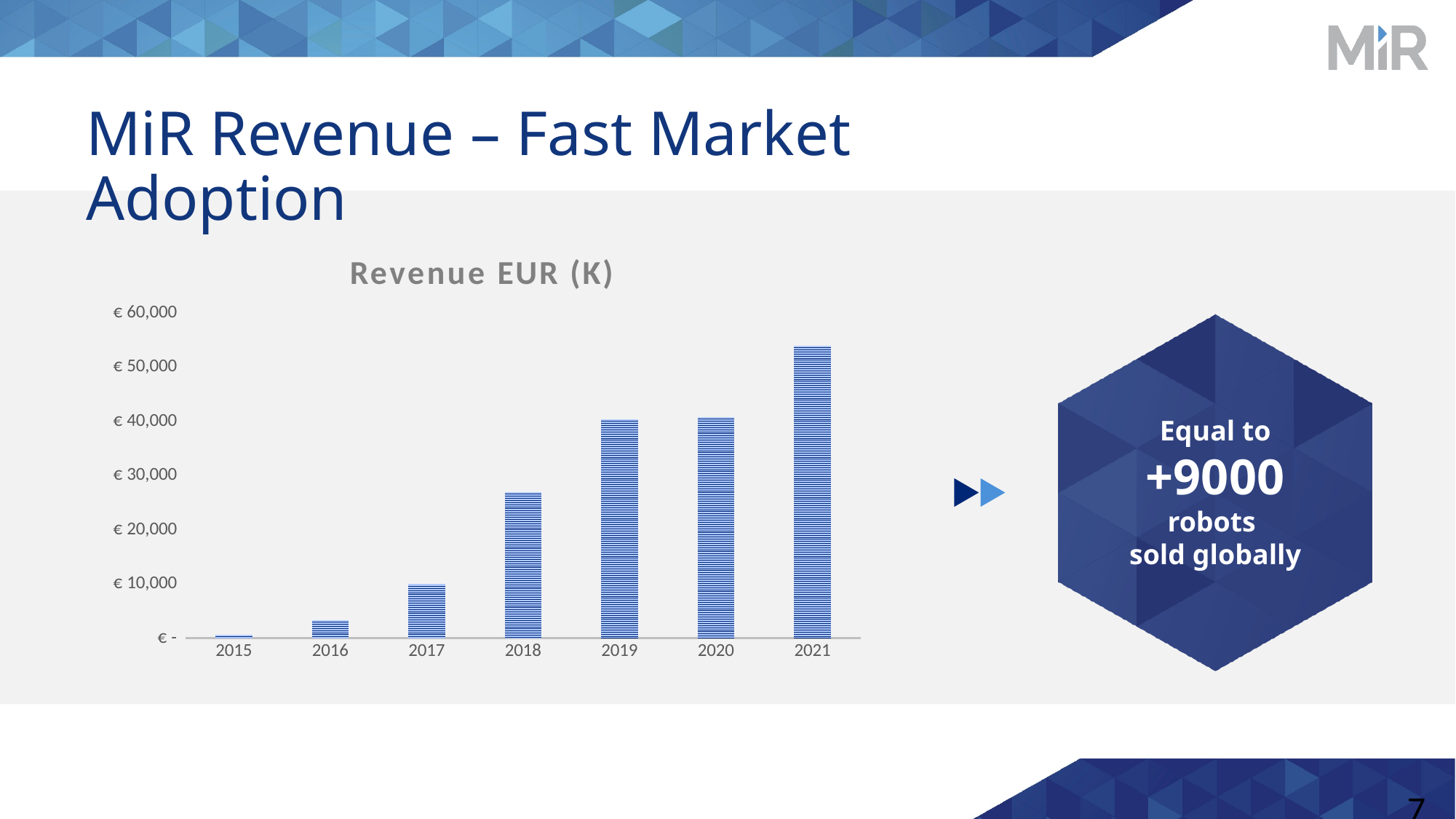
How many years are shown on the x axis of the chart? 7 Which year has the larger revenue, 2018 or 2019? 2019 Is the revenue for 2016 greater or less than € 10,000? less Do the revenue values generally rise or fall from 2015 to 2021? rise What is the title of the chart? Revenue EUR (K) Which year has the highest revenue in the chart? 2021 Which year has the lowest revenue in the chart? 2015 What kind of chart is shown on the slide? bar chart Is the revenue for 2018 greater or less than € 20,000? greater Is the revenue for 2021 greater or less than € 50,000? greater What is the highest value labelled on the y axis of the chart? € 60,000